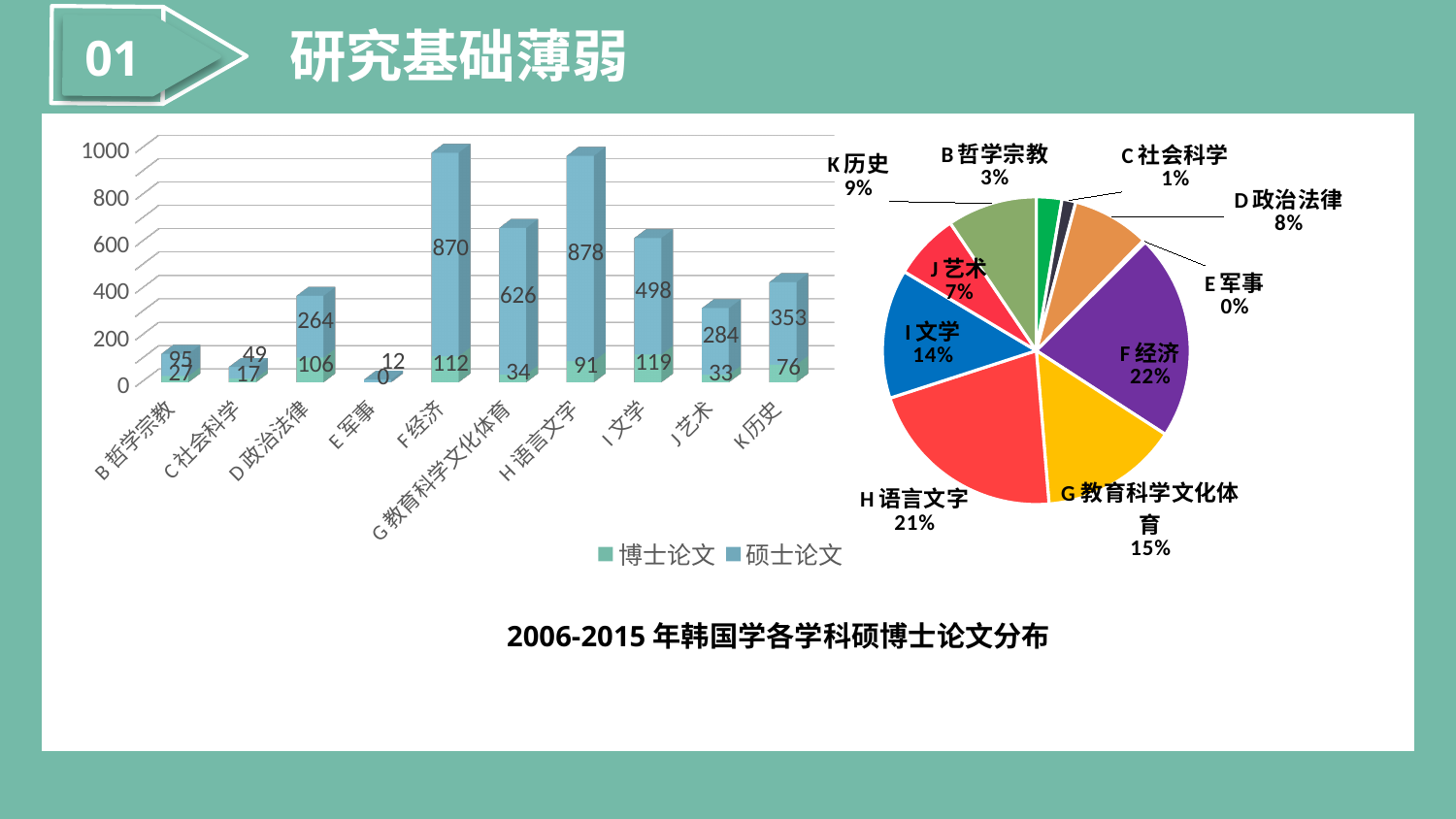
How many categories are shown on the x axis of the bar chart on the left? 10 In the bar chart on the left, what is the value of 博士论文 for I 文学? 119 In the pie chart on the right, which category has the smallest share? E 军事 In the bar chart on the left, which category has the lowest 博士论文 value? E 军事 In the bar chart on the left, which category has the highest 硕士论文 value? H 语言文字 In the pie chart on the right, what share does F 经济 have? 22% In the bar chart on the left, which is larger: the 博士论文 value for D 政治法律 or for K 历史? D 政治法律 What kind of chart is the chart on the right? Pie chart In the bar chart on the left, what is the value of 硕士论文 for F 经济? 870 In the bar chart on the left, what is the difference between the 硕士论文 values for G 教育科学文化体育 and I 文学? 128 How many series does the legend of the bar chart on the left list? 2 In the bar chart on the left, what is the total of the stacked bar for F 经济? 982